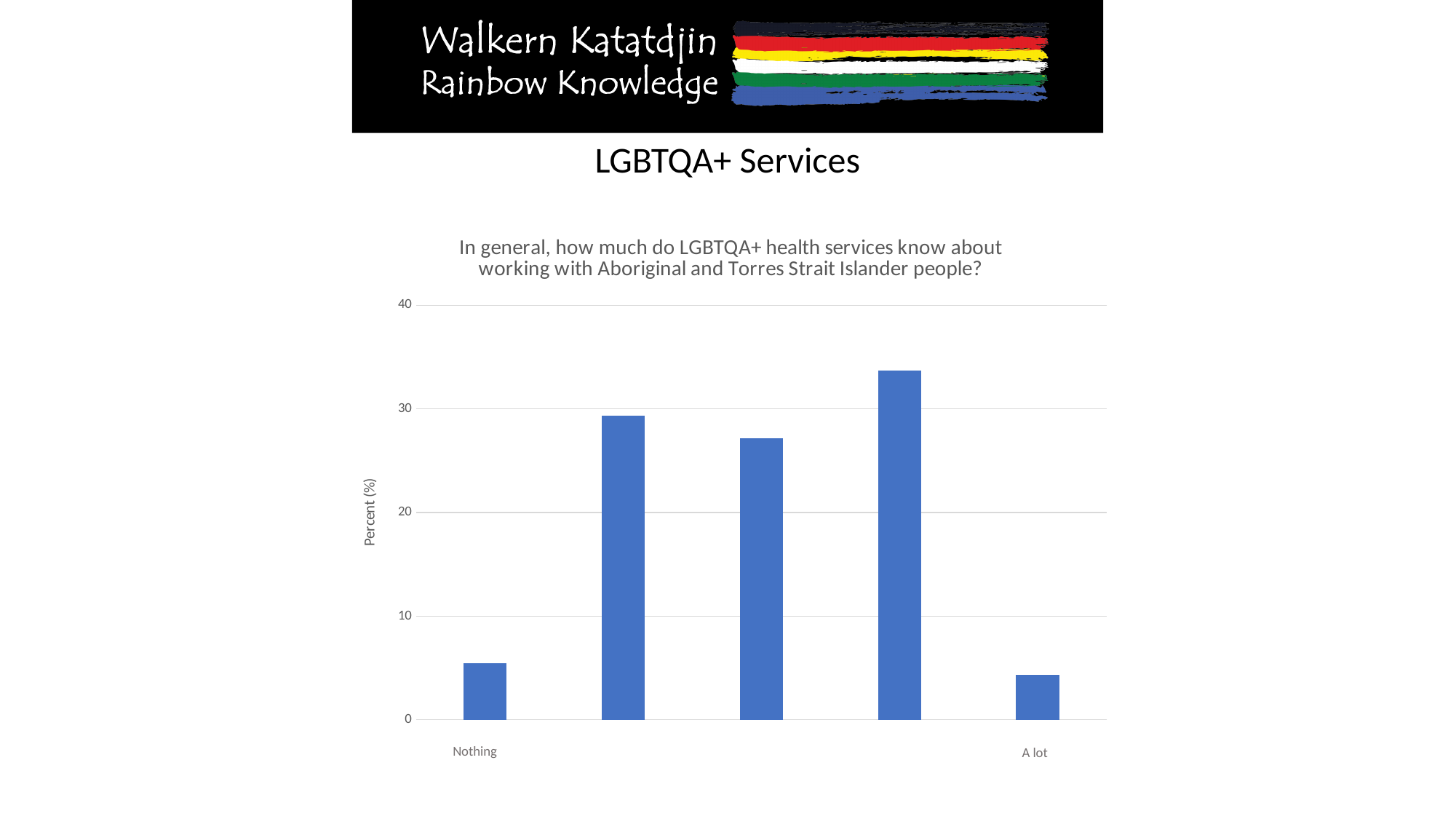
How many bars are plotted in the chart? 5 What kind of chart is shown on the slide? bar chart Is the value for Nothing greater or less than 10? less Is the value for A lot greater or less than 10? less Is the value of the third bar from the left greater or less than 30? less Is the value for Nothing greater or less than the value of the second bar from the left? less What is the label on the vertical axis? Percent (%) What is the highest value shown on the vertical axis? 40 Which position does the tallest bar occupy, counting from the left? fourth